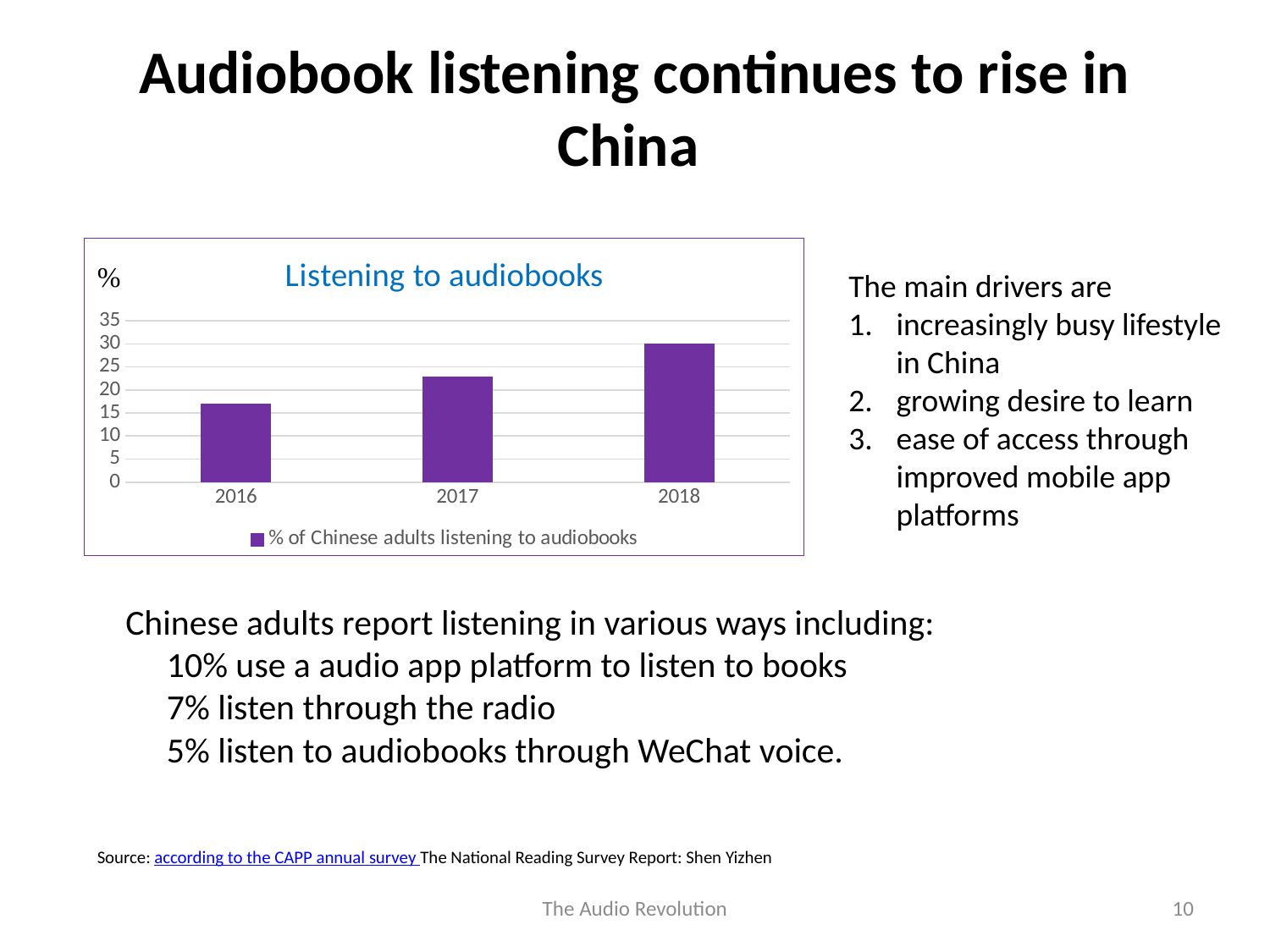
How many years are plotted on the chart? 3 Which is larger, the value for 2017 or the value for 2016? 2017 Is the value for 2016 greater or less than 20? less Which year has the highest percentage of Chinese adults listening to audiobooks? 2018 What series name does the chart legend show? % of Chinese adults listening to audiobooks Do the values rise or fall from 2016 to 2018? rise How many series does the chart legend list? 1 Is the value for 2017 greater or less than 20? greater Is the value for 2018 greater or less than 25? greater What kind of chart is shown on the slide? bar chart Which year has the lowest percentage of Chinese adults listening to audiobooks? 2016 What is the title of the chart? Listening to audiobooks